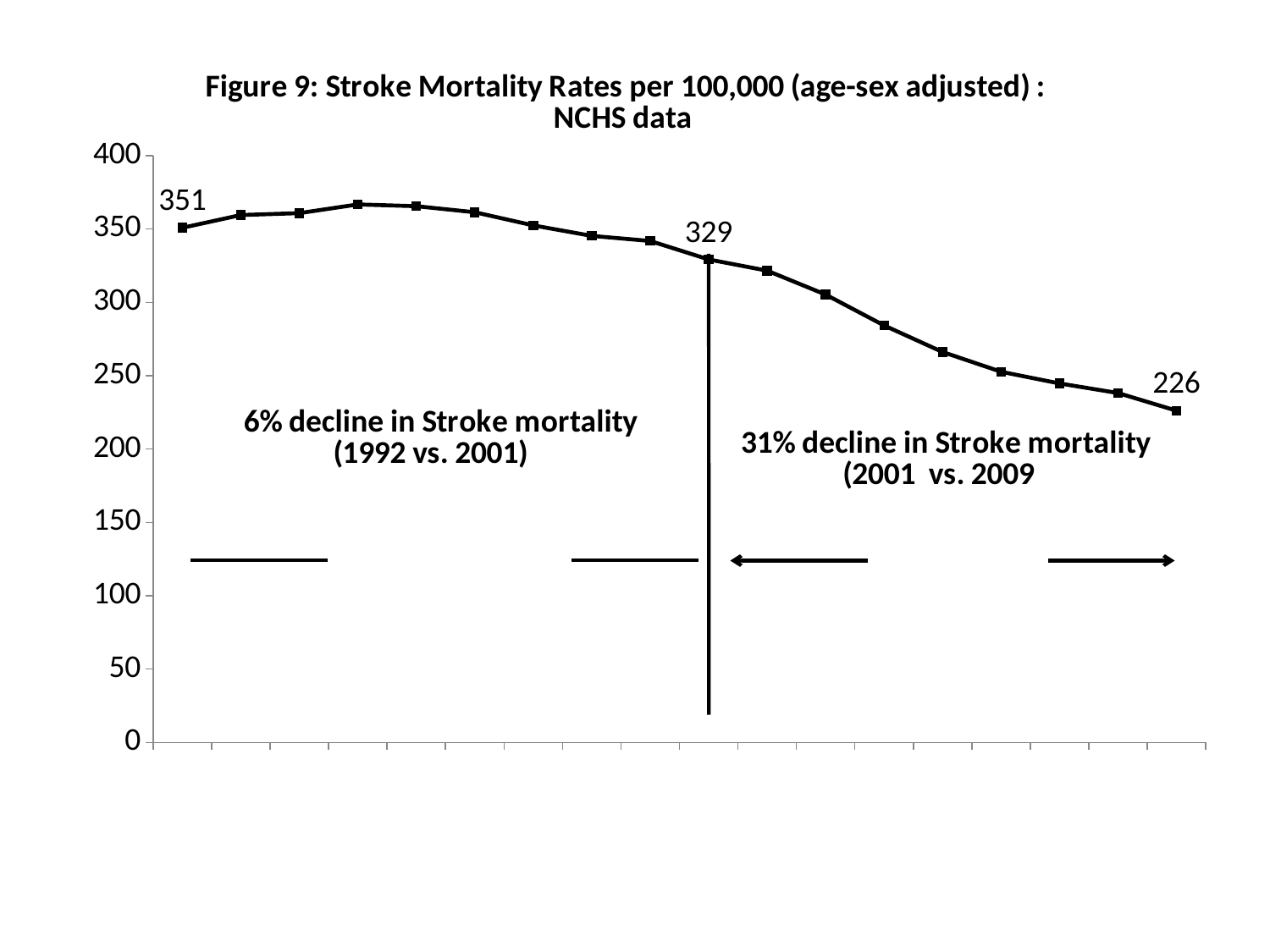
Which labelled value is larger, the first point (351) or the 2001 point (329)? 351 What is the stroke mortality rate labelled at the last point of the line (2009)? 226 According to the annotation on the chart, what percentage decline in stroke mortality occurred between 2001 and 2009? 31% What is the difference between the labelled values at the first point (351) and the last point (226)? 125 What is the stroke mortality rate labelled at the 2001 point, where the vertical line is drawn? 329 Is the value at the highest point of the line greater or less than 350? greater What type of chart is shown on the slide? line chart What is the stroke mortality rate labelled at the first point of the line (1992)? 351 What is the difference between the labelled 2001 value (329) and the labelled 2009 value (226)? 103 Is the value at the last point of the line greater or less than 250? less Overall, do the stroke mortality rates rise or fall from left to right along the x axis? fall How many data points are plotted on the line? 18